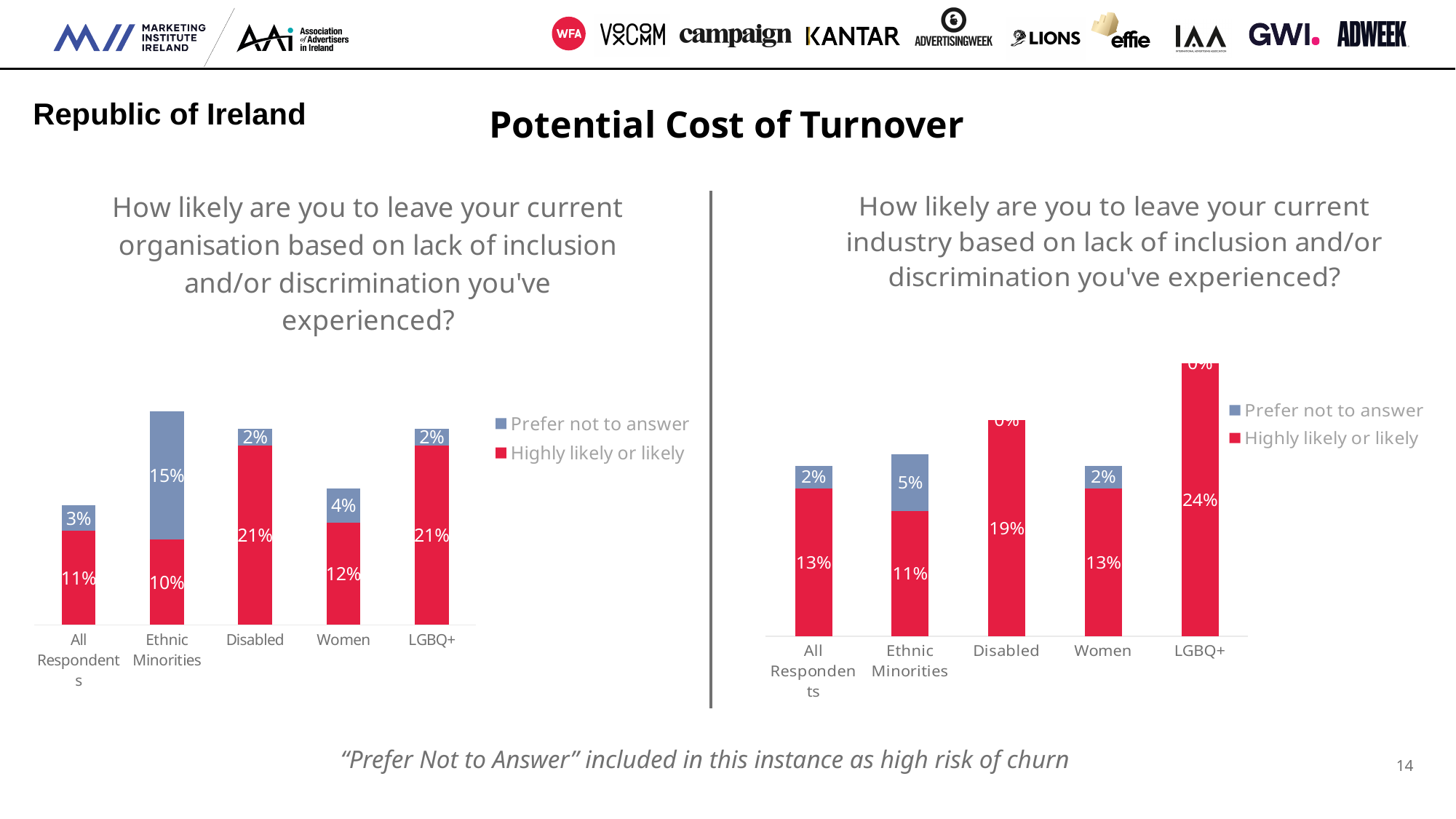
On the right chart (leave your current industry), what is the total stacked value for All Respondents? 15% On the left chart (leave your current organisation), what is the 'Prefer not to answer' value for Ethnic Minorities? 15% On the left chart (leave your current organisation), which category has the lowest 'Highly likely or likely' value? Ethnic Minorities On the right chart (leave your current industry), which category has the highest 'Highly likely or likely' value? LGBQ+ On the right chart (leave your current industry), what is the 'Prefer not to answer' value for Ethnic Minorities? 5% On the right chart (leave your current industry), what is the 'Highly likely or likely' value for LGBQ+? 24% On the left chart (leave your current organisation), what is the 'Highly likely or likely' value for Disabled? 21% How many categories are shown on the left chart (leave your current organisation)? 5 On the left chart (leave your current organisation), which is larger: the 'Prefer not to answer' value for Women or for All Respondents? Women What type of chart is used on the right side of the slide (leave your current industry)? Stacked bar chart On the right chart (leave your current industry), what is the difference between the 'Highly likely or likely' values for LGBQ+ and Disabled? 5% On the left chart (leave your current organisation), what is the total stacked value for Ethnic Minorities? 25%